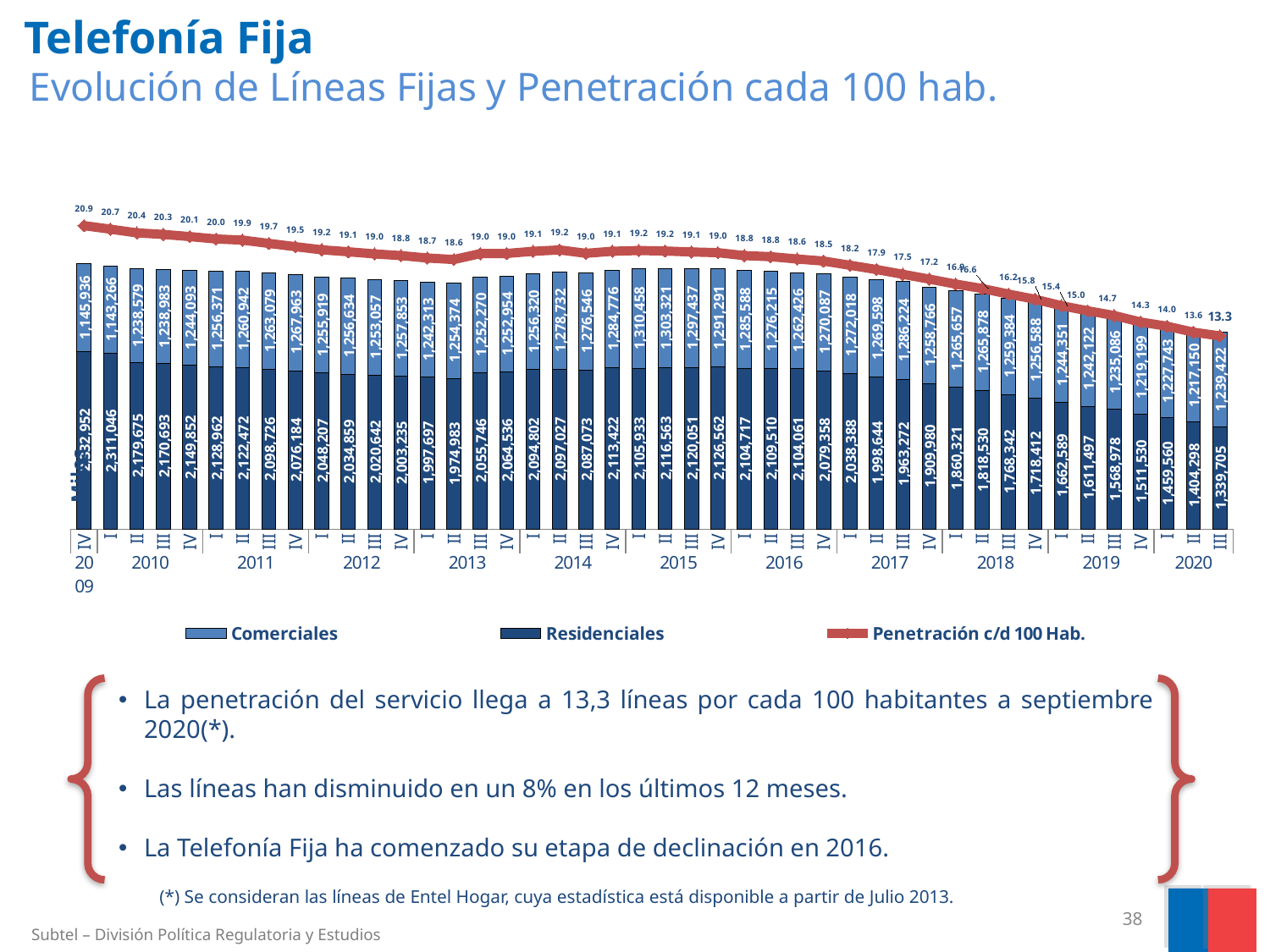
What kind of chart is shown on the slide? Stacked bar chart with a line Does the Penetración c/d 100 Hab. line rise or fall overall from IV 2009 to III 2020? Fall Which is larger, the Residenciales value for I 2014 or for I 2018? I 2014 What is the total of the stacked bar (Comerciales plus Residenciales) for III 2020? 2,579,127 What is the difference between the Penetración c/d 100 Hab. values for IV 2009 and III 2020? 7.6 In which quarter is the Penetración c/d 100 Hab. value highest? IV 2009 What is the Penetración c/d 100 Hab. value for III 2020? 13.3 What is the Residenciales value for IV 2009? 2,332,952 What is the Comerciales value for I 2015? 1,310,458 How many series does the legend list? 3 In which quarter is the Residenciales value lowest? III 2020 What is the difference between the Residenciales values for I 2020 and III 2020? 119,855